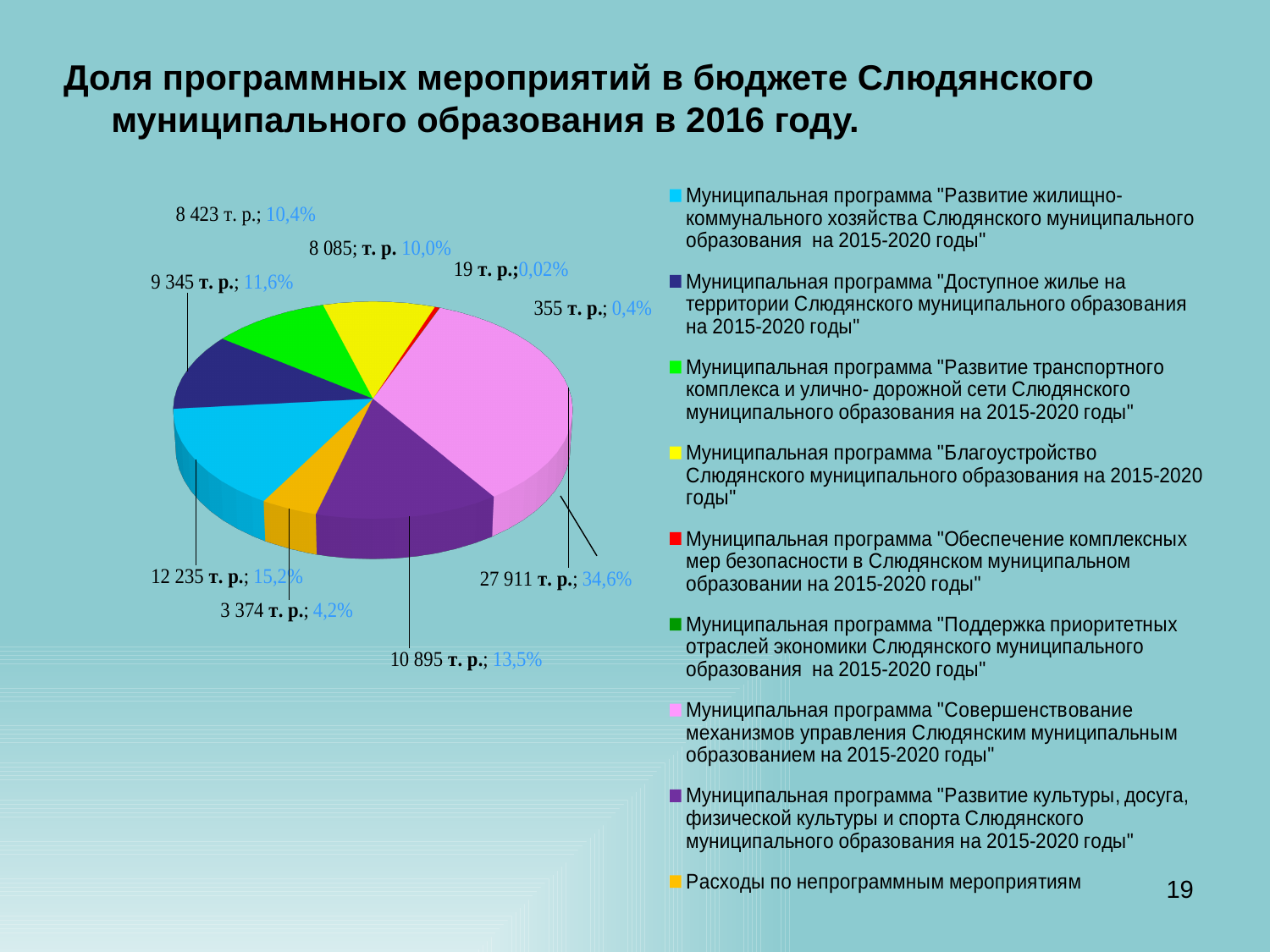
Which slice has the largest share of the pie? Муниципальная программа "Совершенствование механизмов управления Слюдянским муниципальным образованием на 2015-2020 годы" How many entries does the legend list? 9 What value is shown for the slice "Муниципальная программа "Совершенствование механизмов управления Слюдянским муниципальным образованием на 2015-2020 годы""? 27 911 т. р. Which slice has the smallest share of the pie? Муниципальная программа "Поддержка приоритетных отраслей экономики Слюдянского муниципального образования на 2015-2020 годы" Which is larger: the value for "Муниципальная программа "Доступное жилье на территории Слюдянского муниципального образования на 2015-2020 годы"" or for "Муниципальная программа "Развитие транспортного комплекса и улично-дорожной сети Слюдянского муниципального образования на 2015-2020 годы""? Муниципальная программа "Доступное жилье на территории Слюдянского муниципального образования на 2015-2020 годы" What percentage share is shown for "Расходы по непрограммным мероприятиям"? 4,2% What kind of chart is shown on the slide? pie chart What colour is the largest slice of the pie chart? pink How many slices does the pie chart have? 9 What value is shown for the slice "Муниципальная программа "Развитие жилищно-коммунального хозяйства Слюдянского муниципального образования на 2015-2020 годы""? 12 235 т. р. What is the difference in value between the "Развитие жилищно-коммунального хозяйства" slice (12 235 т. р.) and the "Развитие культуры, досуга, физической культуры и спорта" slice (10 895 т. р.)? 1 340 т. р. What percentage share is shown for the slice "Муниципальная программа "Развитие культуры, досуга, физической культуры и спорта Слюдянского муниципального образования на 2015-2020 годы""? 13,5%